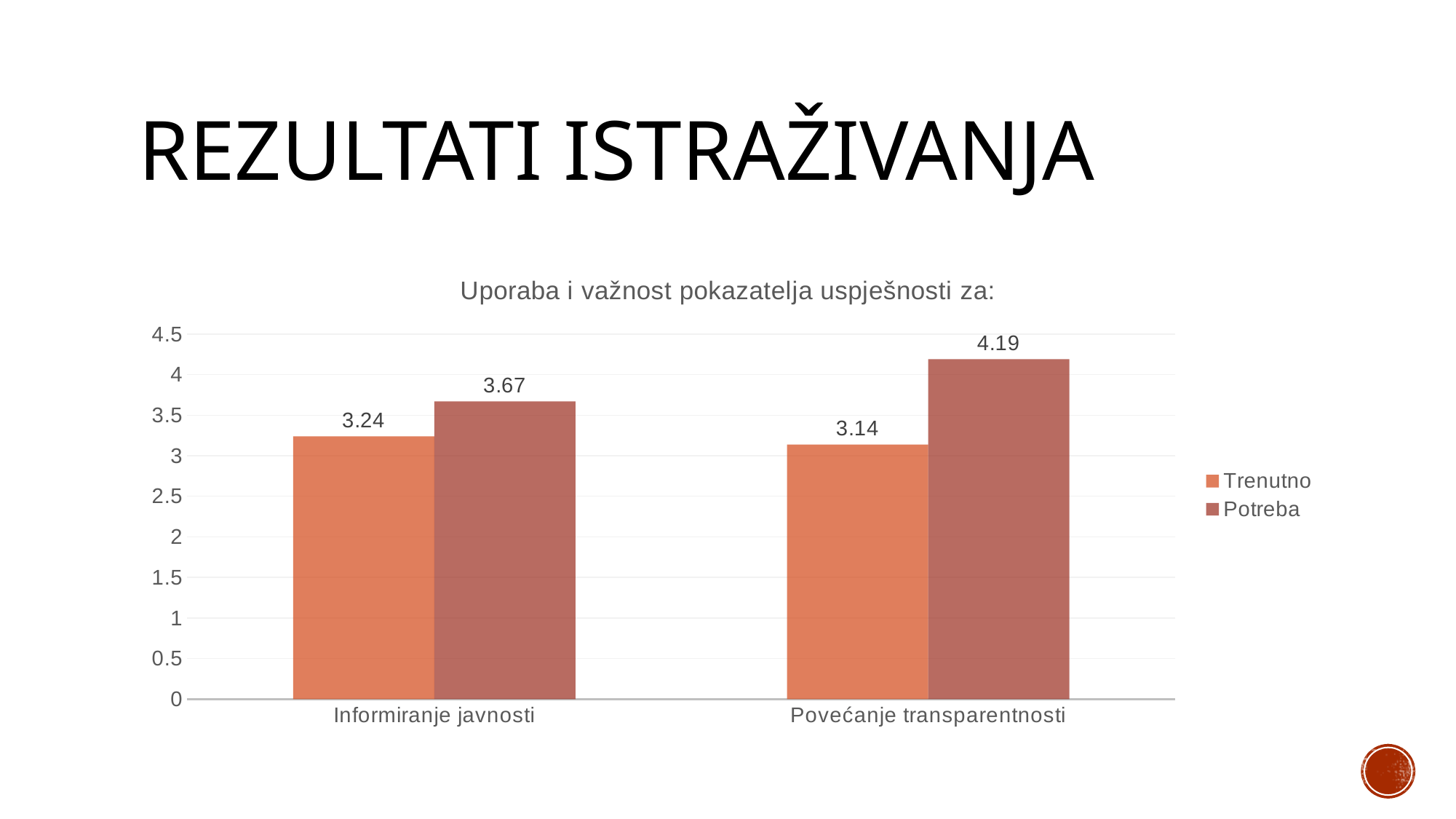
What is the Potreba value for Informiranje javnosti? 3.67 What is the difference between the Potreba and Trenutno values for Informiranje javnosti? 0.43 What is the Trenutno value for Povećanje transparentnosti? 3.14 How many series does the legend list? 2 What kind of chart is shown on the slide? Bar chart What is the Potreba value for Povećanje transparentnosti? 4.19 How many categories are shown on the x axis? 2 Which category has the lowest Trenutno value? Povećanje transparentnosti What is the Trenutno value for Informiranje javnosti? 3.24 Which is larger for Informiranje javnosti, Trenutno or Potreba? Potreba Which category has the highest Potreba value? Povećanje transparentnosti What is the difference between the Potreba and Trenutno values for Povećanje transparentnosti? 1.05